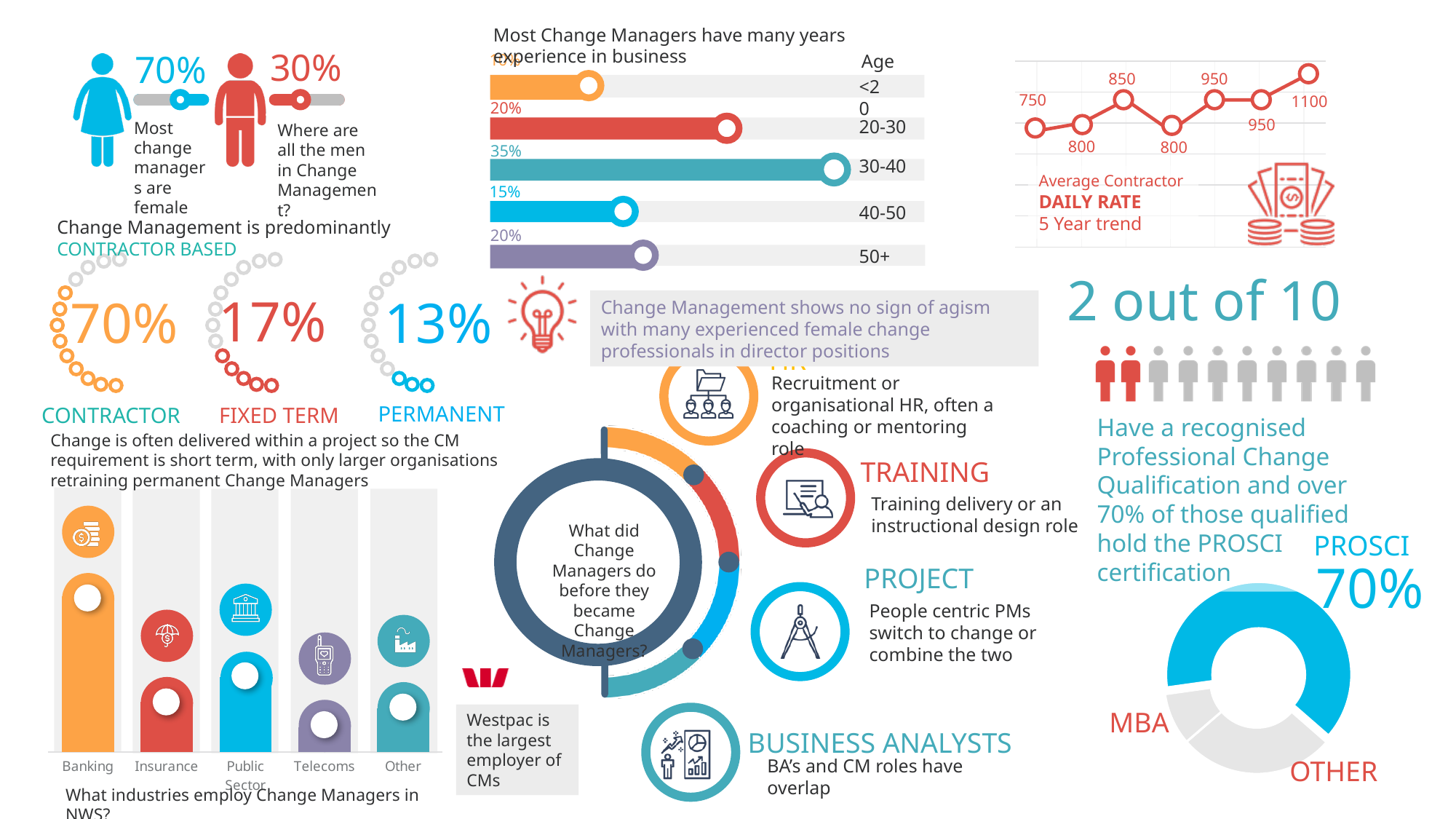
In the industries bar chart at the bottom left, which industry has the tallest bar? Banking In the Average Contractor Daily Rate 5 Year trend line chart, what is the lowest value shown? 750 How many data points are plotted in the Average Contractor Daily Rate line chart? 7 In the age bar chart, which is larger: the percentage for 20-30 or for 40-50? 20-30 In the age bar chart, what is the difference in percentage between the 30-40 group and the 40-50 group? 20% How many industries are shown in the bar chart asking which industries employ Change Managers in NSW? 5 In the Average Contractor Daily Rate 5 Year trend line chart, what is the highest value shown? 1100 In the age bar chart, what percentage of Change Managers are aged 40-50? 15% In the age bar chart, what percentage of Change Managers are aged 30-40? 35% In the age bar chart, which age group has the highest percentage? 30-40 In the Average Contractor Daily Rate line chart, what is the difference between the last value and the first value? 350 In the donut chart at the bottom right, what share is shown for PROSCI? 70%